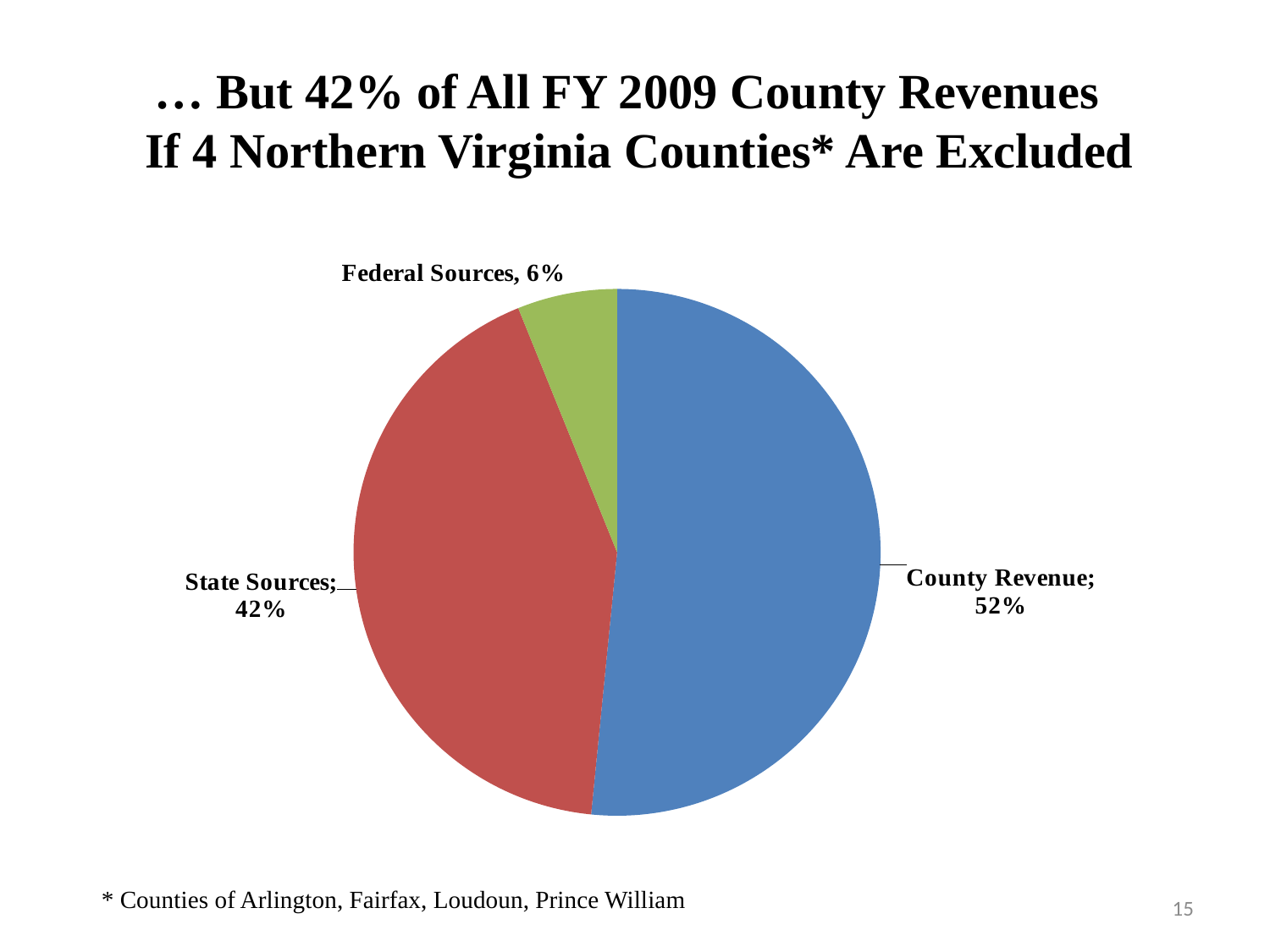
What colour is the County Revenue slice? Blue What kind of chart is shown on the slide? Pie chart What share of the pie is Federal Sources? 6% Which is larger, County Revenue or State Sources? County Revenue What is the difference in percentage points between State Sources and Federal Sources? 36 Which slice of the pie is the smallest? Federal Sources What share of the pie is State Sources? 42% What is the difference in percentage points between County Revenue and State Sources? 10 Which slice of the pie is the largest? County Revenue Which is larger, State Sources or Federal Sources? State Sources What share of the pie is County Revenue? 52% How many slices does the pie chart have? 3